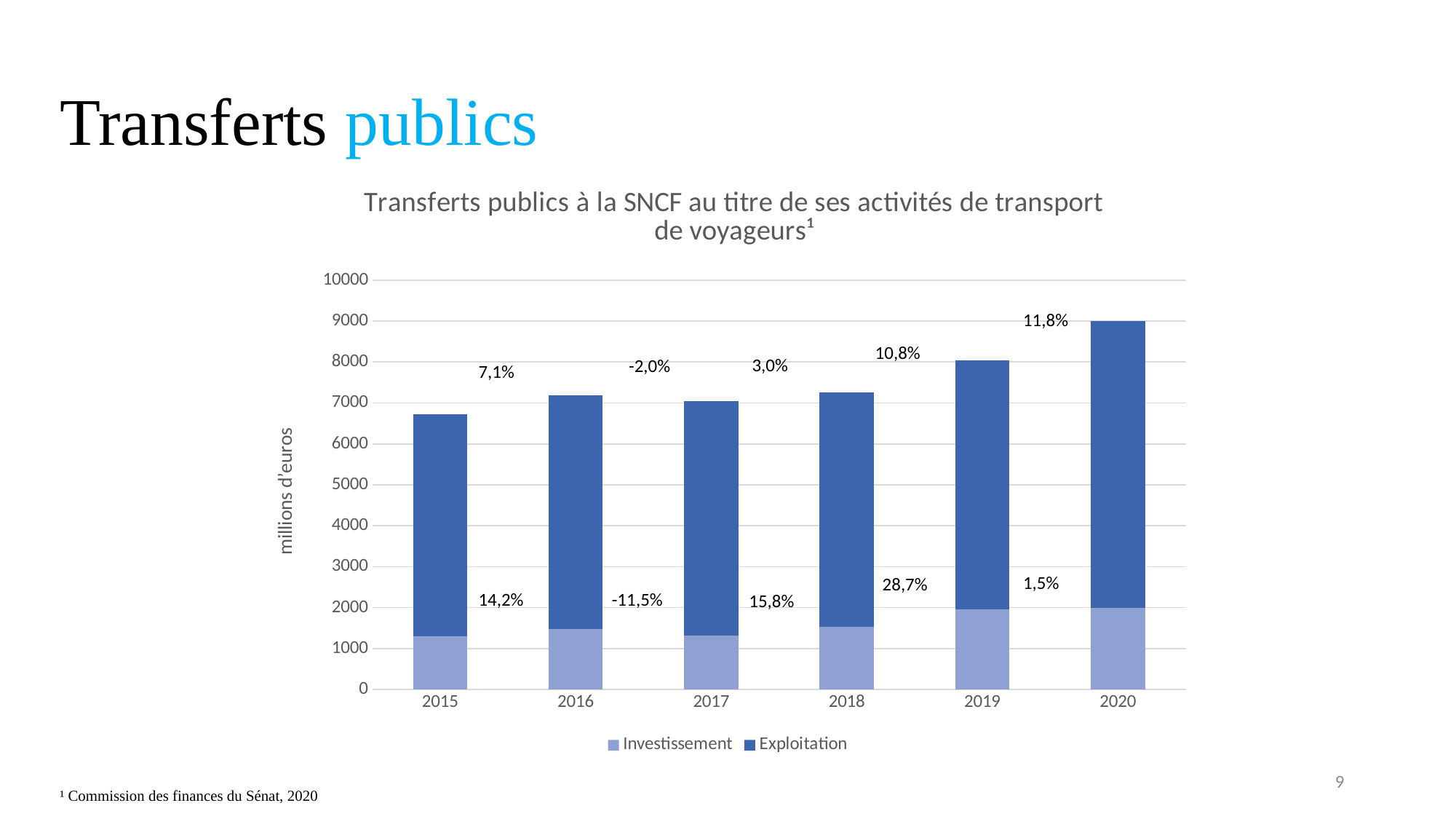
Which year has the tallest total bar? 2020 What kind of chart is shown on the slide? stacked bar chart What percentage label is printed near the top of the 2020 bar? 11,8% Which total bar is taller, 2019 or 2018? 2019 How many years are shown on the x axis of the chart? 6 Which year has the shortest total bar? 2015 Do the total transfers generally rise or fall from 2015 to 2020? rise Is the Investissement segment for 2015 greater or less than 2000 millions d'euros? less How many series does the chart legend list? 2 Is the total bar for 2020 greater or less than 8000 millions d'euros? greater What is the label of the y axis of the chart? millions d'euros Is the total bar for 2015 greater or less than 7000 millions d'euros? less